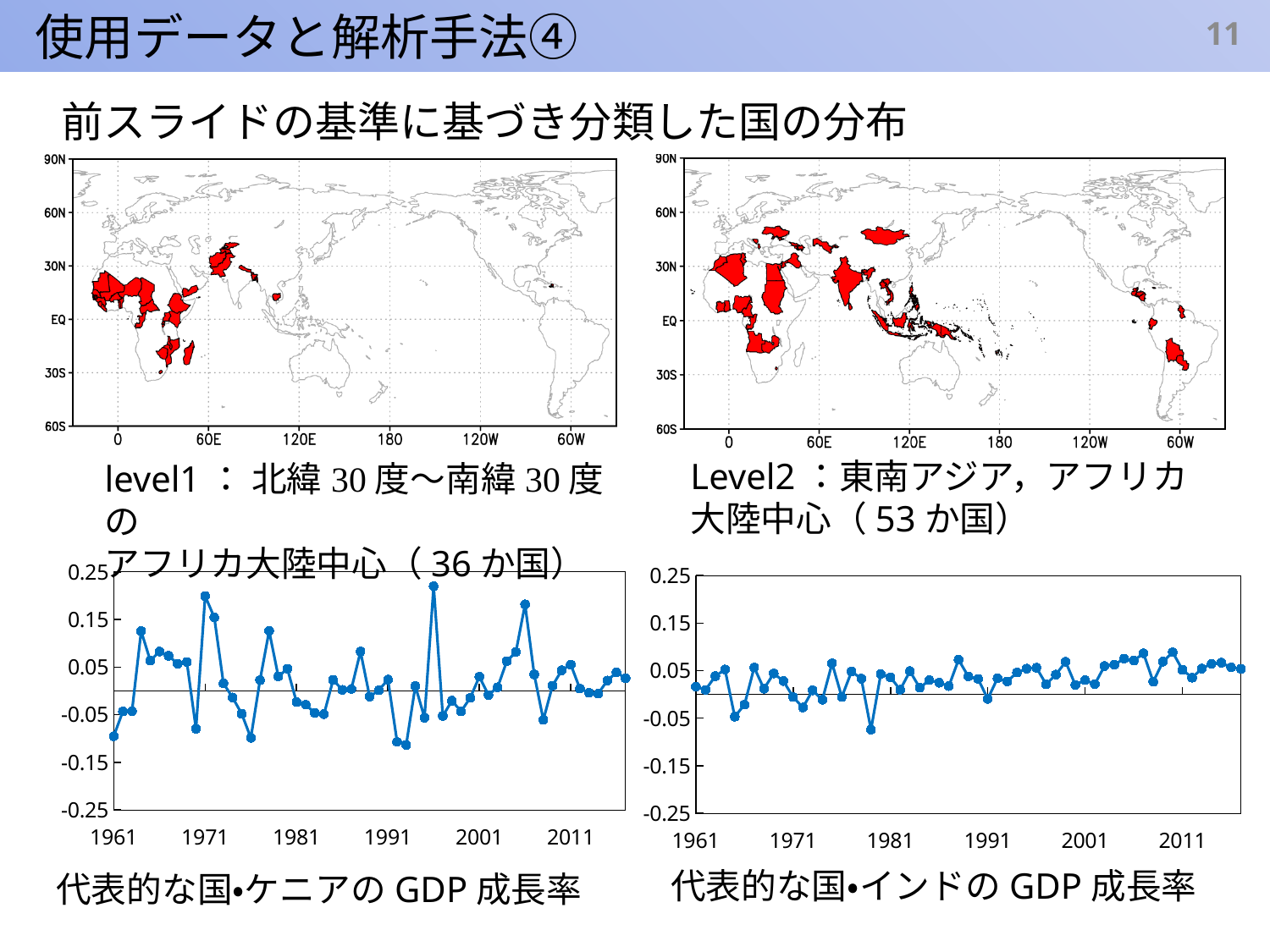
In the bottom-right India GDP growth rate chart, is the value for 2011 greater or less than -0.05? greater What is the first year labelled on the x axis of the bottom-left Kenya GDP growth rate chart? 1961 In the bottom-left Kenya GDP growth rate chart, is the value for 1991 greater or less than 0.05? less In the bottom-left Kenya GDP growth rate chart, is the value for 1971 greater or less than 0.15? greater What kind of chart is the bottom-left chart showing Kenya's GDP growth rate (代表的な国•ケニアのGDP成長率)? line chart What kind of chart is the bottom-right chart showing India's GDP growth rate (代表的な国•インドのGDP成長率)? line chart Which country's GDP growth rate is plotted in the bottom-left line chart? Kenya (ケニア) What is the maximum value labelled on the y axis of the bottom-right India GDP growth rate chart? 0.25 Which country's GDP growth rate is plotted in the bottom-right line chart? India (インド)